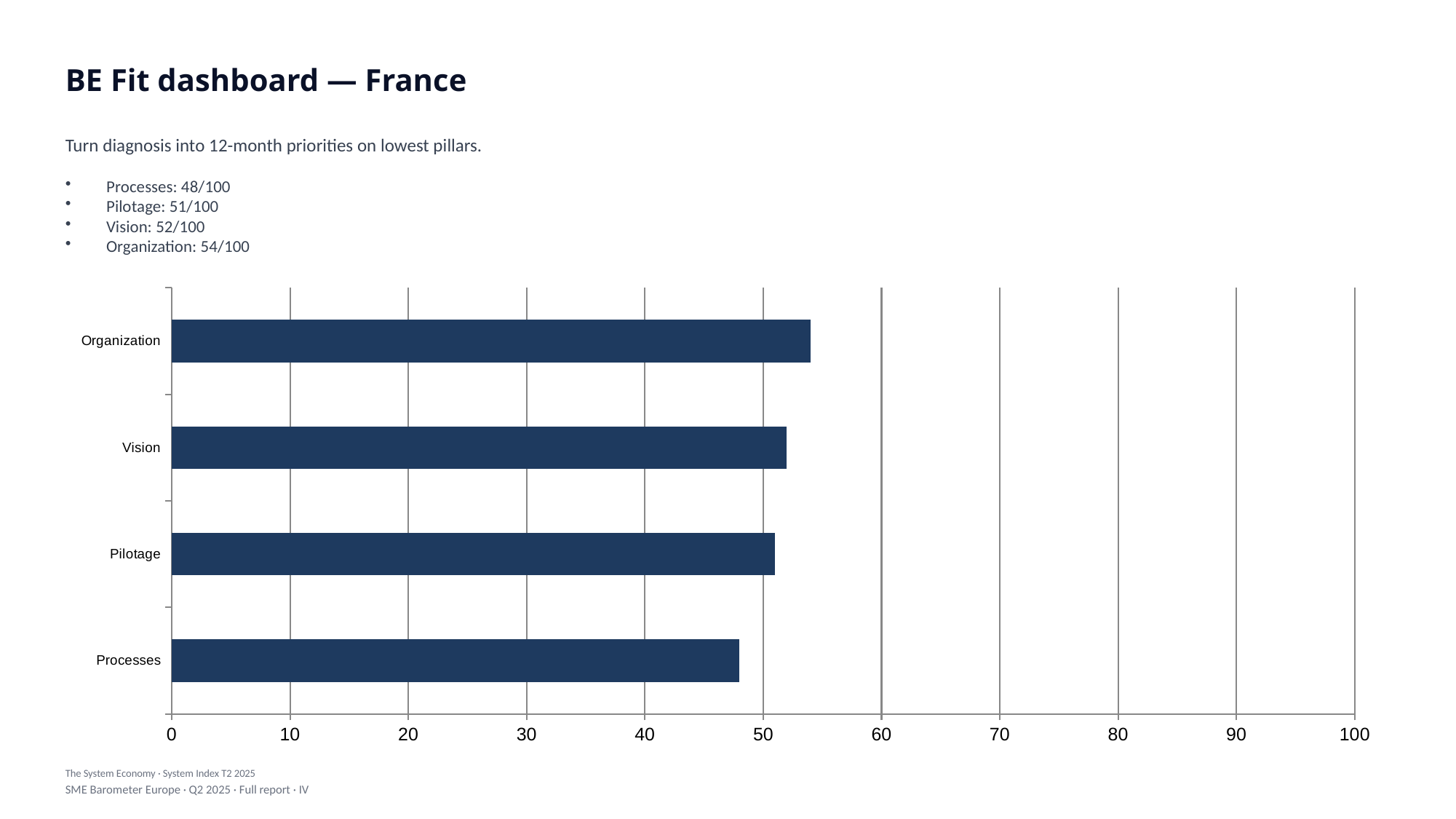
Which category has the highest value? Organization How many categories are plotted in the chart? 4 What is the difference between the values for Organization and Processes? 6 Which is larger, the value for Organization or the value for Processes? Organization What is the value for Vision? 52/100 What is the value for Organization? 54/100 What is the maximum value shown on the horizontal axis? 100 Which category has the lowest value? Processes Is the value for Processes greater or less than 50? less What is the value for Processes? 48/100 What kind of chart is shown on the slide? bar chart Is the value for Organization greater or less than 50? greater